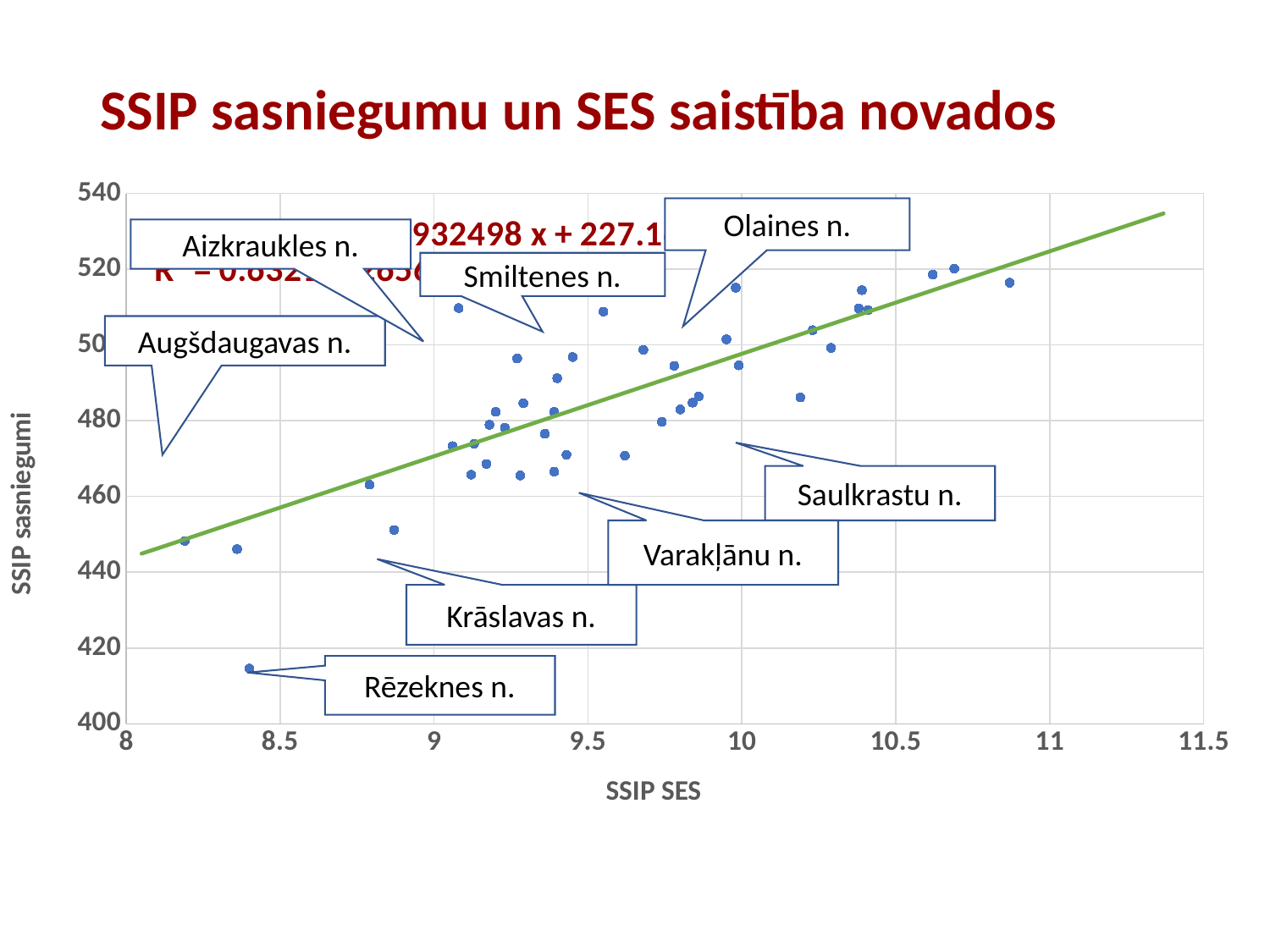
Do the SSIP sasniegumi values generally rise or fall as SSIP SES increases along the x axis? Rise Is the SSIP sasniegumi value for Krāslavas n. greater or less than 460? less Which of the labelled points has the lowest SSIP sasniegumi value? Rēzeknes n. What kind of chart is shown on the slide? Scatter plot What is the title of the chart? SSIP sasniegumu un SES saistība novados Is the SSIP sasniegumi value for Rēzeknes n. greater or less than 420? less Which has the higher SSIP SES value, Saulkrastu n. or Augšdaugavas n.? Saulkrastu n. Which has the higher SSIP sasniegumi value, Olaines n. or Rēzeknes n.? Olaines n. What is the label of the x axis? SSIP SES